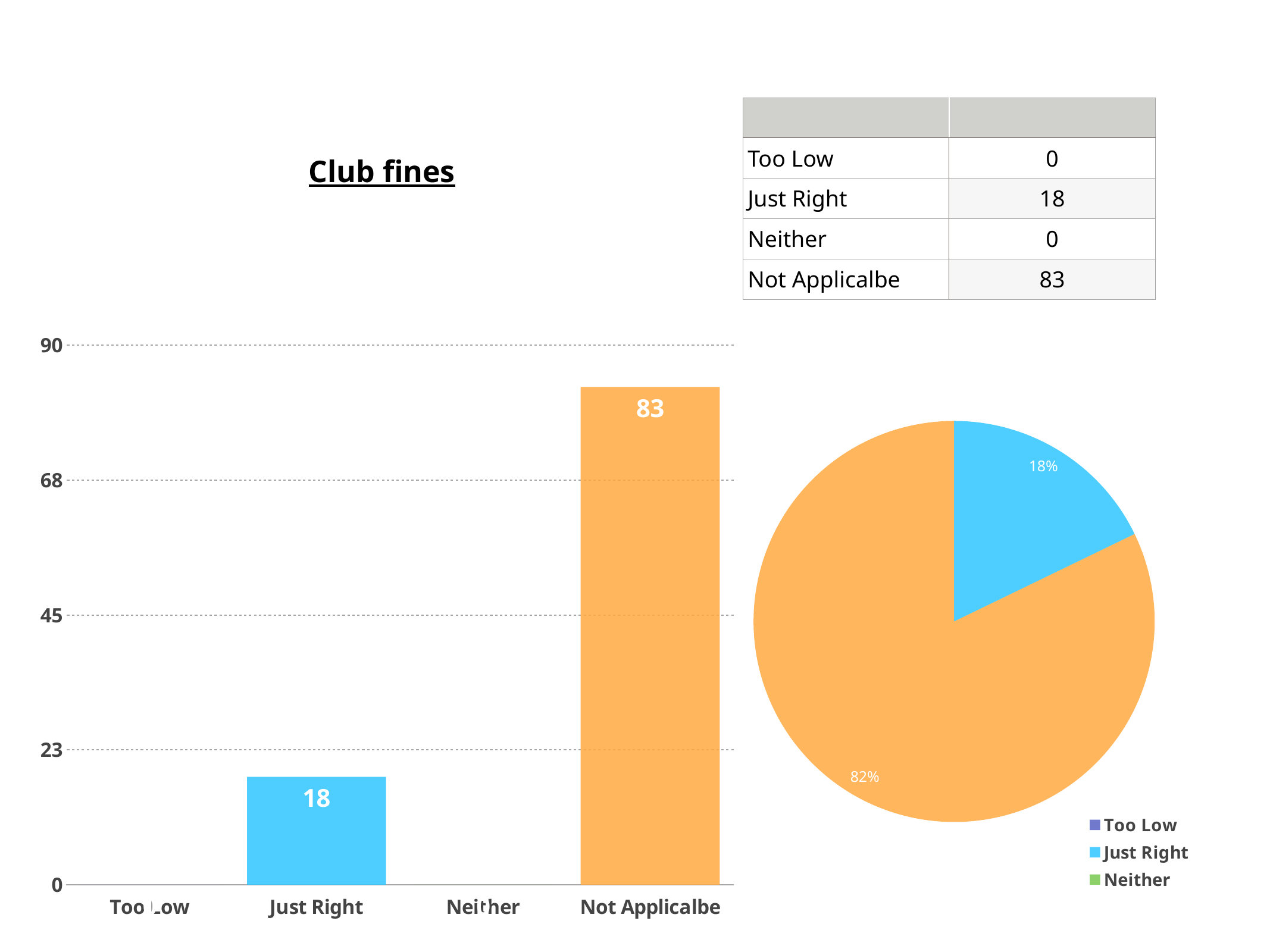
In the bar chart titled Club fines, what is the value for Not Applicalbe? 83 In the bar chart titled Club fines, what is the difference between the values for Not Applicalbe and Just Right? 65 How many entries does the legend of the pie chart on the right of the slide list? 3 In the bar chart titled Club fines, which is larger, the value for Just Right or the value for Not Applicalbe? Not Applicalbe In the pie chart on the right of the slide, what share does the Just Right slice have? 18% In the bar chart titled Club fines, what is the value for Just Right? 18 In the bar chart titled Club fines, is the value for Not Applicalbe greater or less than 68? greater How many categories are shown on the x axis of the bar chart titled Club fines? 4 In the bar chart titled Club fines, which category has the highest value? Not Applicalbe What kind of chart is the chart on the right of the slide? pie chart In the pie chart on the right of the slide, what share does the largest slice have? 82% What kind of chart is the chart titled Club fines on the left of the slide? bar chart